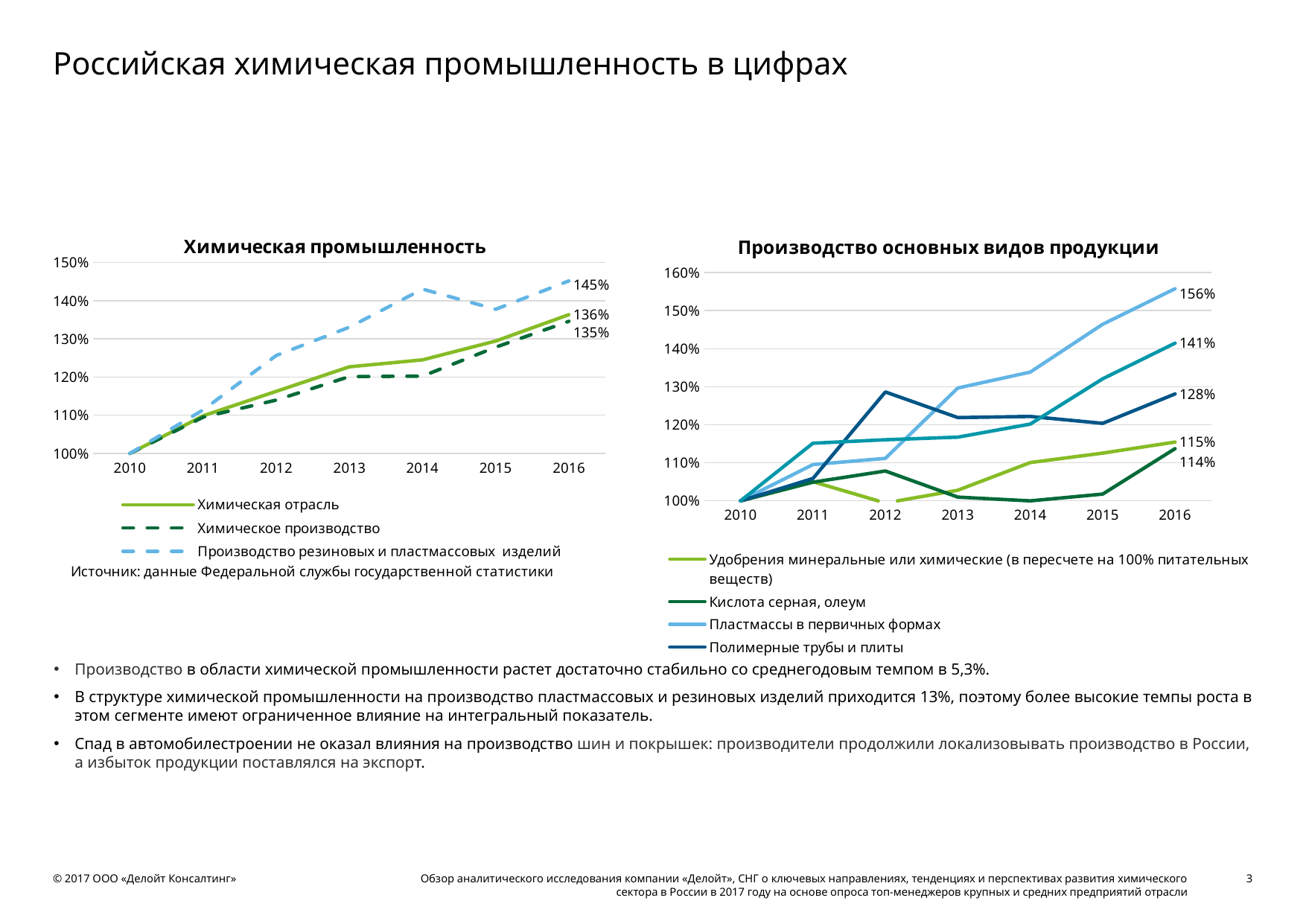
How many series does the legend of the "Химическая промышленность" chart list? 3 In the "Химическая промышленность" chart, what is the value for Производство резиновых и пластмассовых изделий in 2016? 145% In the "Производство основных видов продукции" chart, what is the value for Полимерные трубы и плиты in 2016? 128% What kind of chart is the "Химическая промышленность" chart? line chart In the "Химическая промышленность" chart, what is the difference between Производство резиновых и пластмассовых изделий and Химическая отрасль in 2016? 9 percentage points In the "Производство основных видов продукции" chart, is the value for Полимерные трубы и плиты in 2012 greater or less than 120%? greater In the "Химическая промышленность" chart, which series has the highest value in 2016? Производство резиновых и пластмассовых изделий In the "Производство основных видов продукции" chart, what is the value for Пластмассы в первичных формах in 2016? 156% In the "Производство основных видов продукции" chart, does the line for Пластмассы в первичных формах rise or fall from 2012 to 2016? rise In the "Производство основных видов продукции" chart, what is the difference between Пластмассы в первичных формах and Полимерные трубы и плиты in 2016? 28 percentage points How many years are plotted on the x axis of the "Производство основных видов продукции" chart? 7 In the "Химическая промышленность" chart, what is the value for Химическая отрасль in 2016? 136%